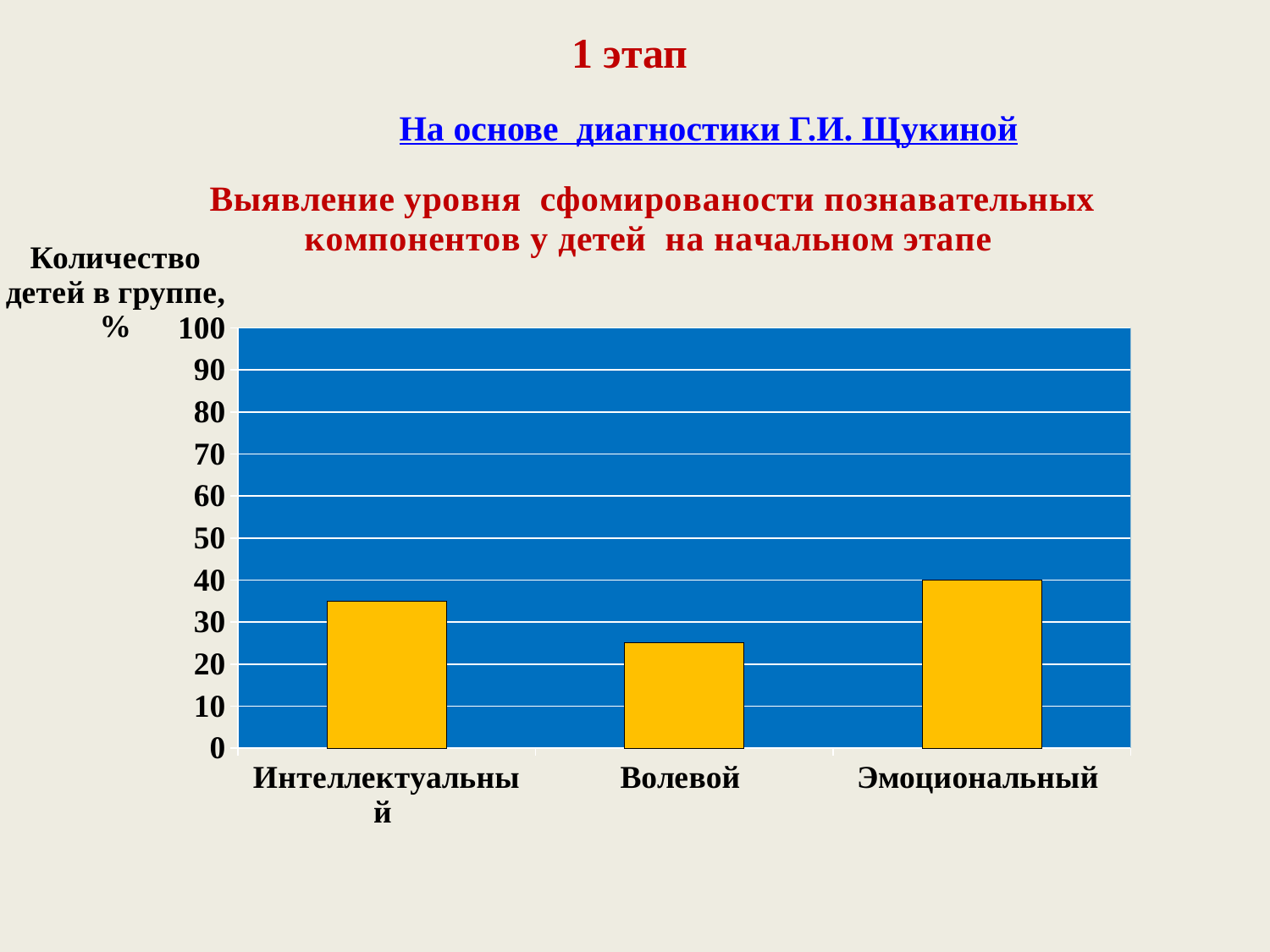
What is the value for Эмоциональный? 40 Which is larger, the value for Интеллектуальный or the value for Волевой? Интеллектуальный What is the label of the vertical axis of the chart? Количество детей в группе, % Is the value for Интеллектуальный greater or less than 40? less What colour are the bars in the chart? yellow Which category has the highest bar? Эмоциональный What kind of chart is shown on the slide? bar chart How many categories are shown on the x axis of the chart? 3 Is the value for Волевой greater or less than 20? greater Which category has the lowest bar? Волевой Is the value for Волевой greater or less than 30? less